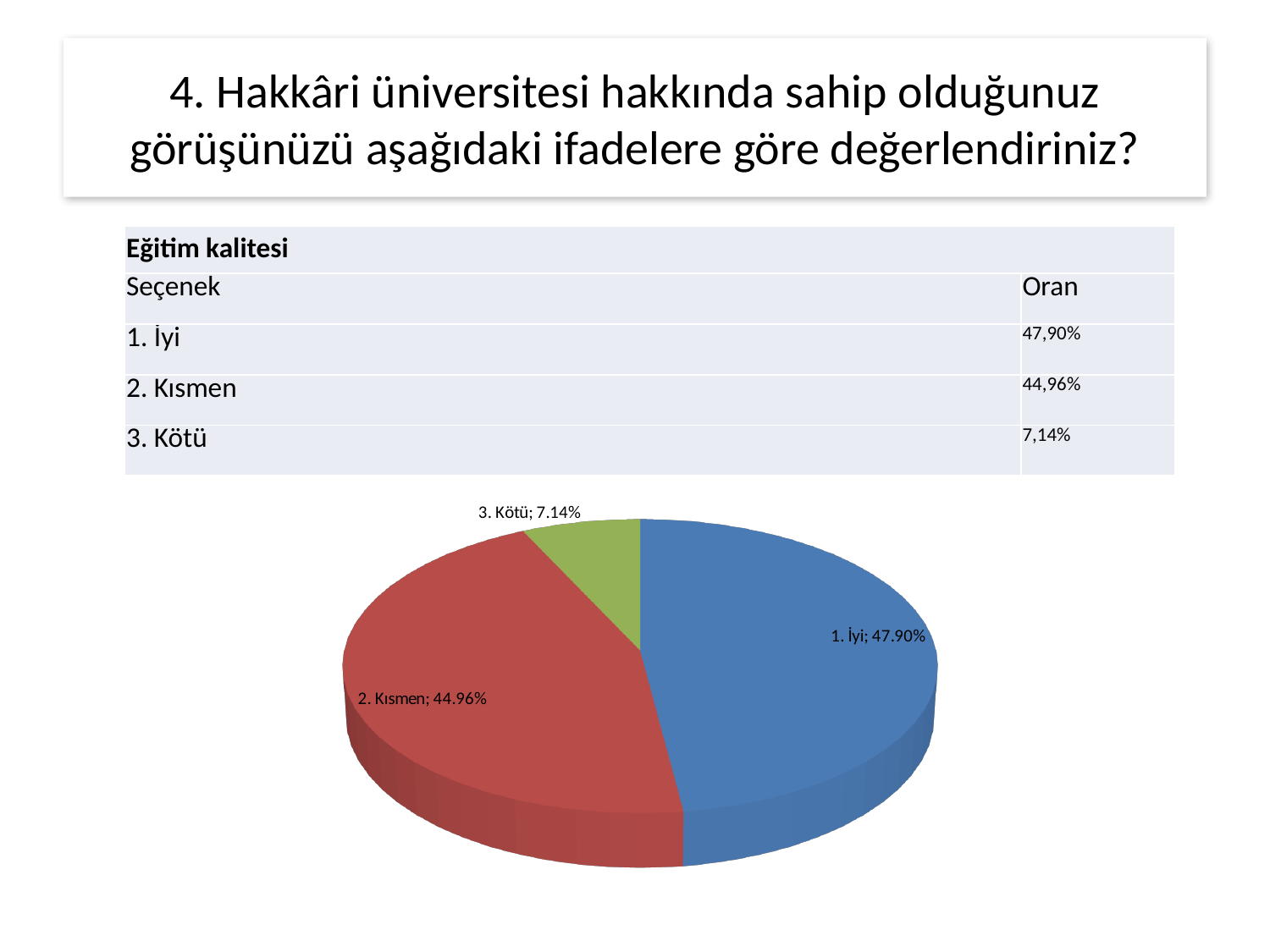
Which is larger in the pie chart, the "2. Kısmen" slice or the "3. Kötü" slice? 2. Kısmen What is the difference in percentage points between the "2. Kısmen" slice and the "3. Kötü" slice? 37.82% What colour is the "1. İyi" slice in the pie chart? blue Which slice of the pie chart is the largest? 1. İyi What share of the pie does the slice "1. İyi" represent? 47.90% What is the difference in percentage points between the "1. İyi" slice and the "2. Kısmen" slice? 2.94% What kind of chart is shown on the slide? pie chart Which slice of the pie chart is the smallest? 3. Kötü What colour is the "3. Kötü" slice in the pie chart? green What share of the pie does the slice "2. Kısmen" represent? 44.96% How many slices does the pie chart have? 3 What share of the pie does the slice "3. Kötü" represent? 7.14%